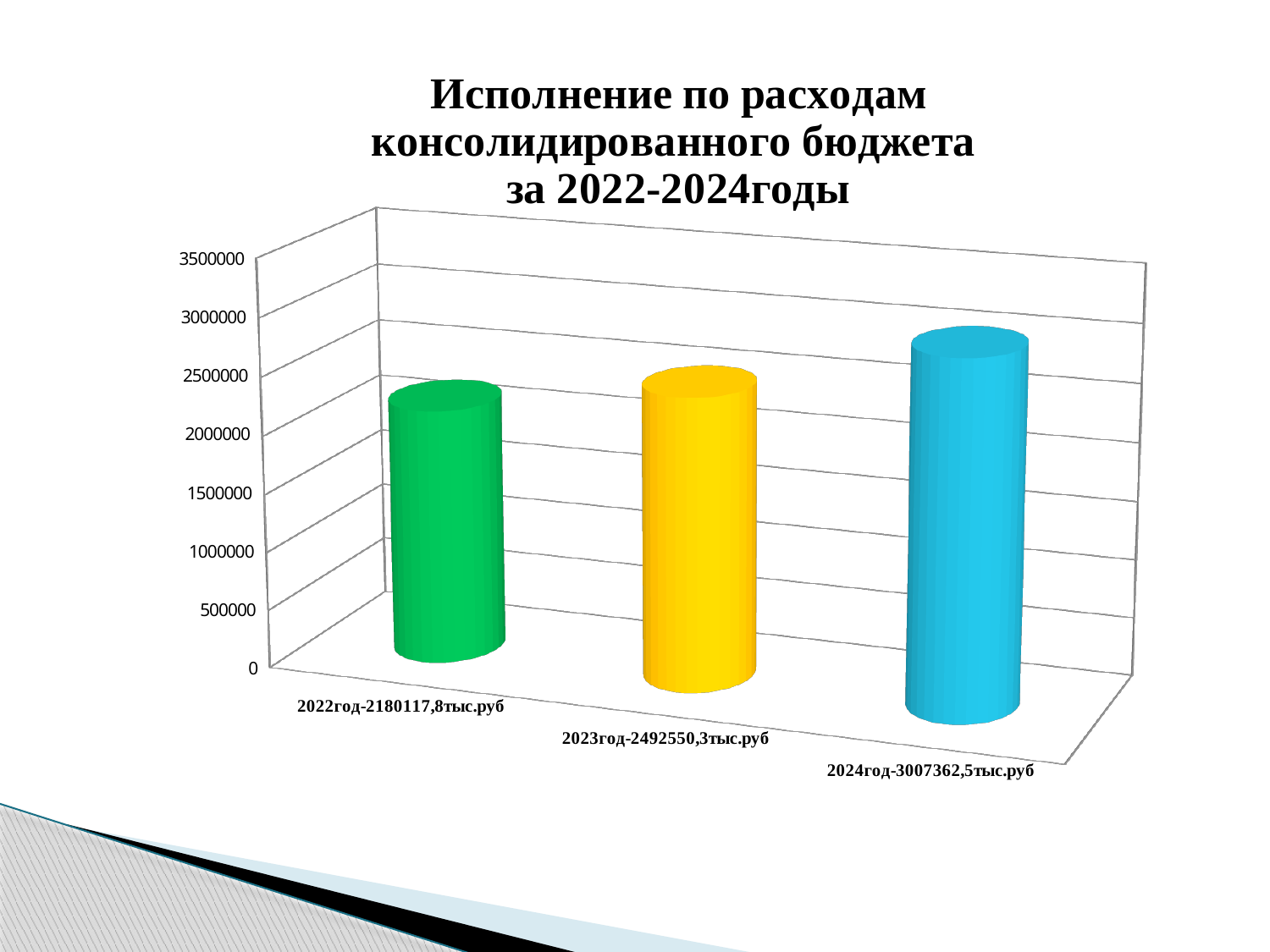
Is the value for 2022 greater or less than 2500000? less What value is printed for 2024 in the category label? 3007362,5тыс.руб How many years (categories) are shown in the chart? 3 What is the difference between the 2023 value and the 2022 value? 312432,5тыс.руб Which is larger, the value for 2023 or the value for 2024? 2024 Do the values rise or fall from 2022 to 2024? rise What is the difference between the 2024 value and the 2022 value? 827244,7тыс.руб What kind of chart is shown on the slide? bar chart What value is printed for 2023 in the category label? 2492550,3тыс.руб Which year has the lowest expenditure value? 2022год What value is printed for 2022 in the category label? 2180117,8тыс.руб Which year has the highest expenditure value? 2024год